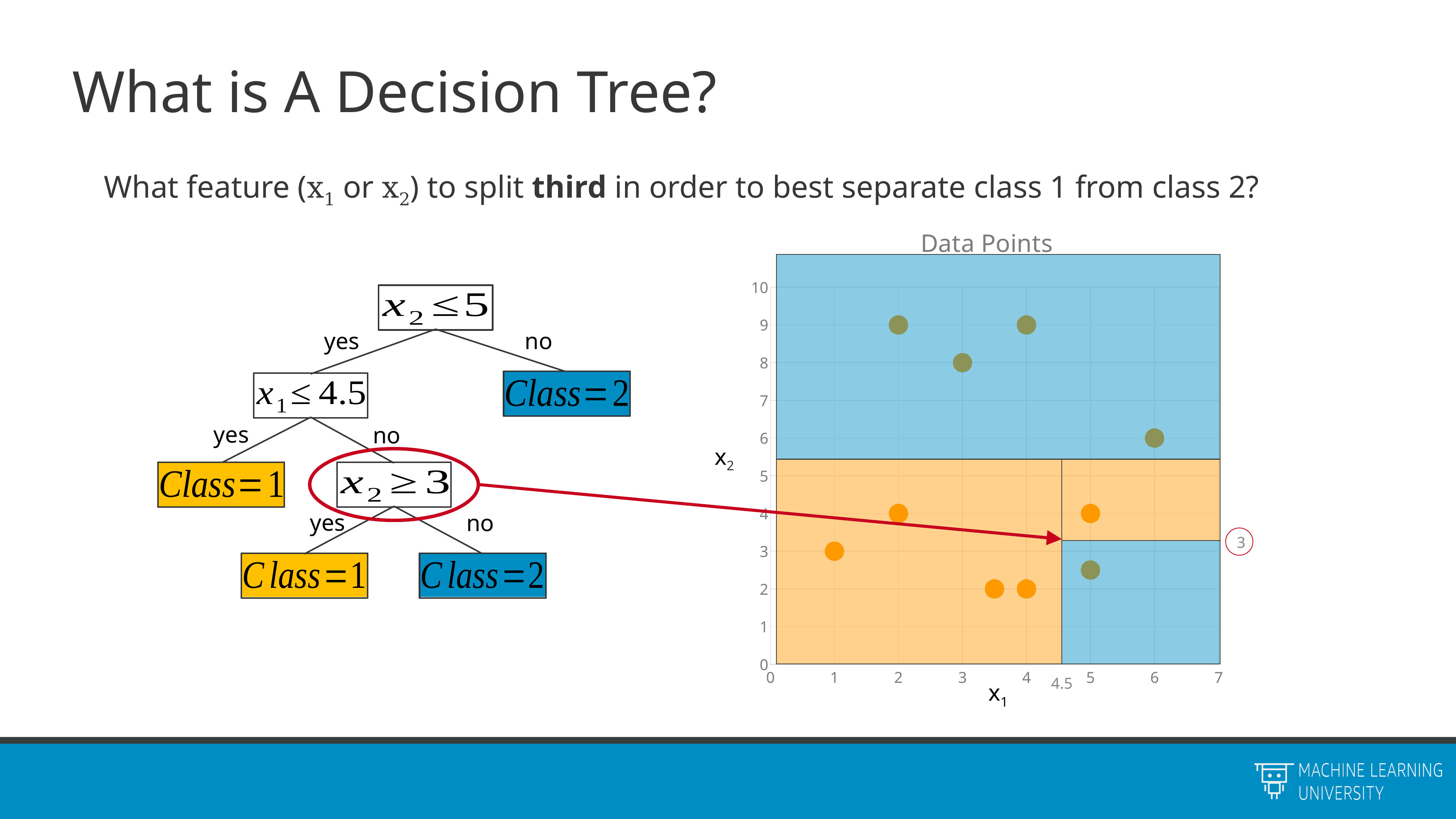
What is the title of the scatter chart on the slide? Data Points What kind of chart is the "Data Points" chart? scatter chart On the "Data Points" chart, how many points lie in the blue region above the x2 = 5 split line? 4 How many data points are plotted on the "Data Points" chart? 10 What is the label of the horizontal axis on the "Data Points" chart? x1 On the "Data Points" chart, what is the x2 value of the point plotted at x1 = 6? 6 On the "Data Points" chart, is the x1 value of the orange point at x2 = 3 greater or less than 4.5? less On the "Data Points" chart, what is the x2 value of the point plotted at x1 = 1? 3 On the "Data Points" chart, which point has the largest x1 value: the olive point at x2 = 6 or the orange point at x2 = 3? the olive point at x2 = 6 On the "Data Points" chart, is the x2 value of the olive point at x1 = 6 greater or less than 5? greater How many olive-green data points are plotted on the "Data Points" chart? 5